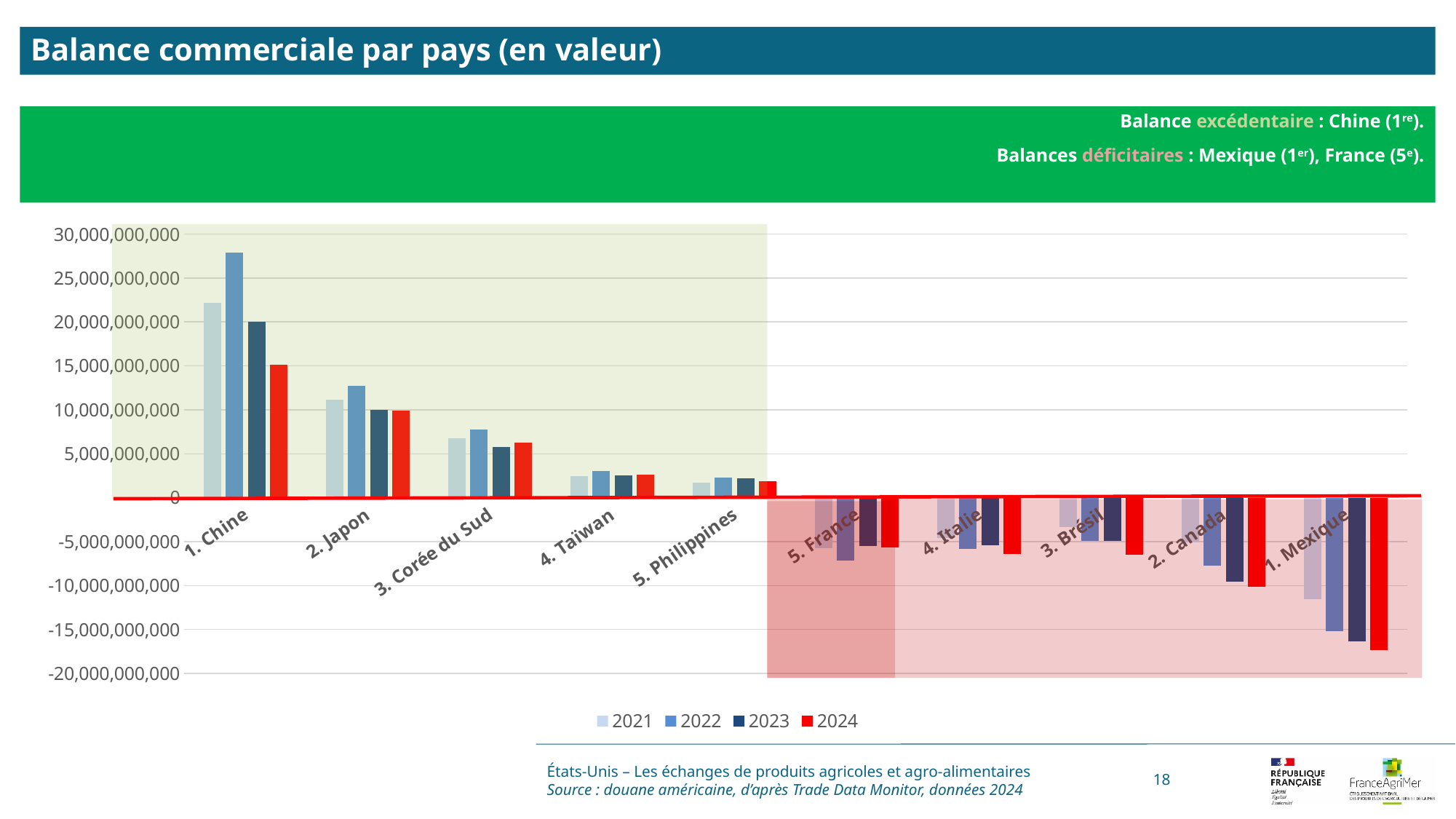
Is the 2022 value for 1. Chine greater or less than 25,000,000,000? greater Which is larger, the 2022 value for 2. Japon or the 2022 value for 3. Corée du Sud? 2. Japon Which country has the lowest 2024 value in the chart? 1. Mexique Is the 2024 value for 1. Mexique greater or less than -15,000,000,000? less How many series does the legend list? 4 Is the 2024 value for 1. Chine greater or less than 20,000,000,000? less Which country has the highest 2024 value in the chart? 1. Chine How many countries are shown on the x axis of the chart? 10 Which series is shown in red in the legend? 2024 Do the values for 1. Mexique rise or fall from 2021 to 2024? fall What kind of chart is shown on the slide? bar chart